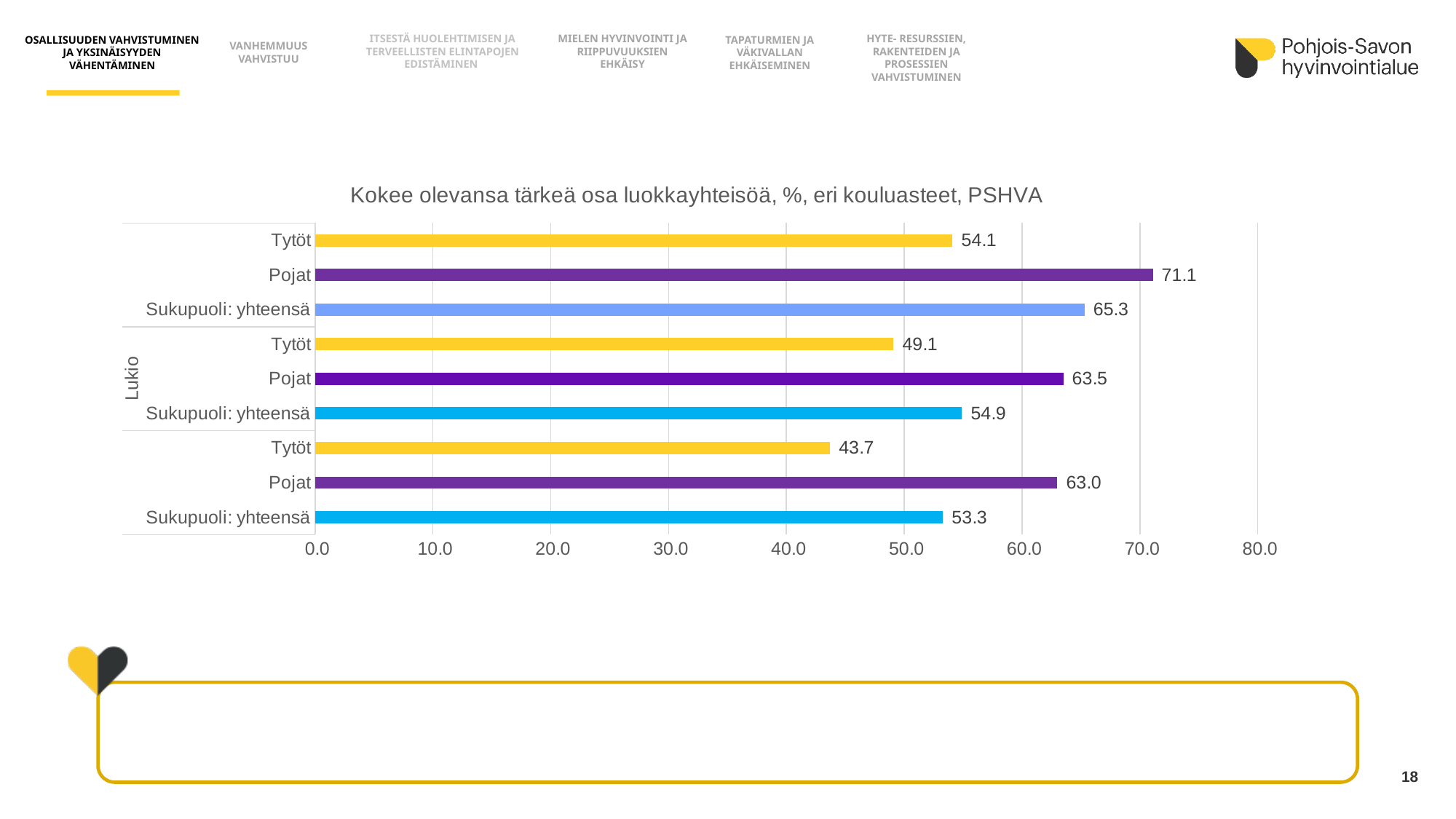
What kind of chart is shown on the slide? Bar chart What is the difference between Pojat and Tytöt in the Lukio group? 14.4 In the Lukio group, which is larger: Pojat or Sukupuoli: yhteensä? Pojat How many bars are plotted in the chart? 9 Which bar has the lowest value in the chart? Tytöt in the bottommost group (43.7) Which bar has the highest value in the chart? Pojat in the topmost group (71.1) What is the value for Tytöt in the Lukio group? 49.1 What is the value for Pojat in the topmost group of bars? 71.1 What is the value for Tytöt in the bottommost group of bars? 43.7 What is the value for Pojat in the Lukio group? 63.5 What is the value for Sukupuoli: yhteensä in the Lukio group? 54.9 What is the title of the chart? Kokee olevansa tärkeä osa luokkayhteisöä, %, eri kouluasteet, PSHVA